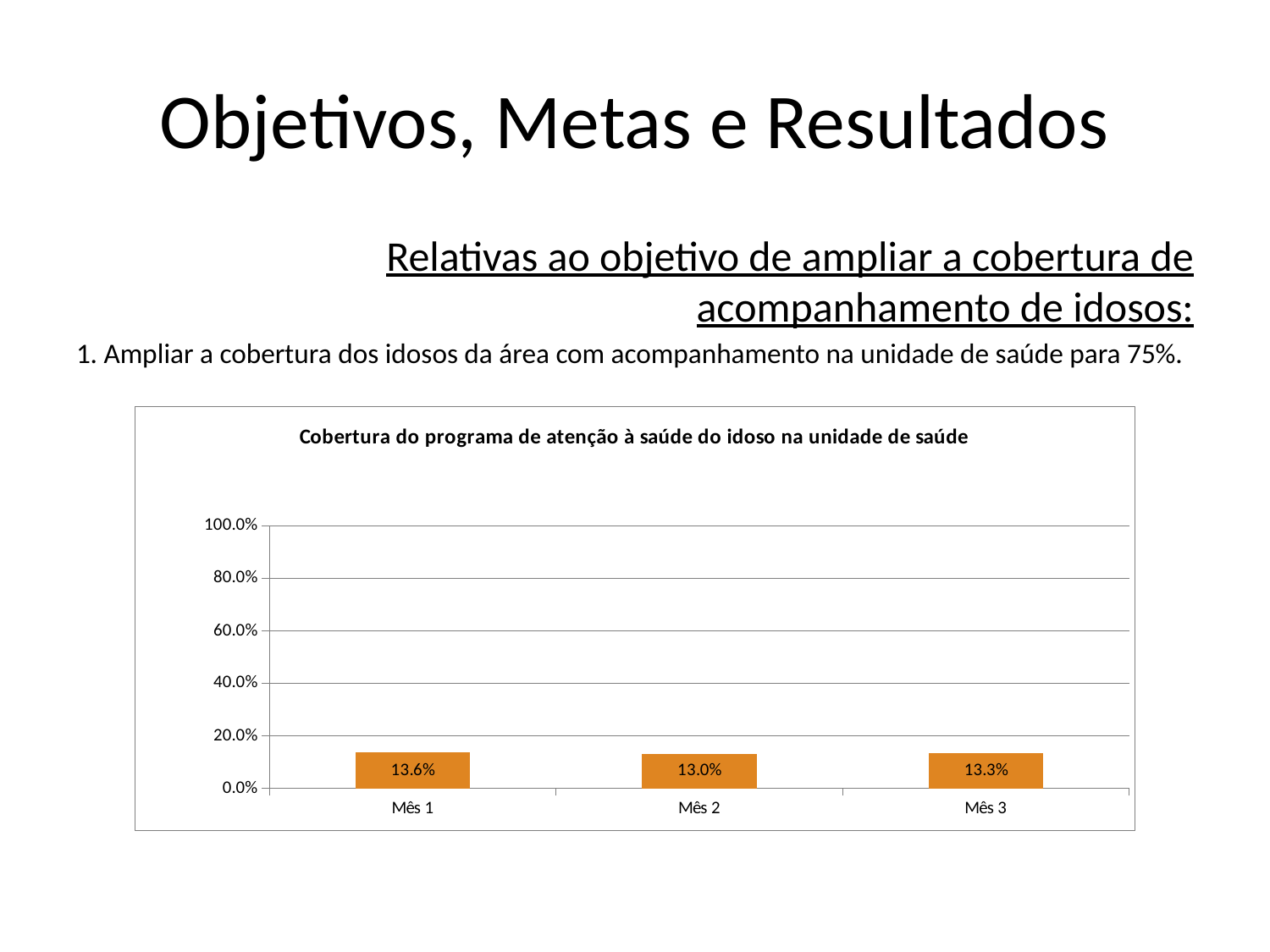
What is the title of the chart? Cobertura do programa de atenção à saúde do idoso na unidade de saúde What is the value for Mês 3? 13.3% Which month has the highest coverage value? Mês 1 What is the difference between the values for Mês 3 and Mês 2? 0.3% Which is larger, the value for Mês 1 or the value for Mês 3? Mês 1 What is the value for Mês 2? 13.0% What kind of chart is shown on the slide? bar chart What is the difference between the values for Mês 1 and Mês 2? 0.6% How many months (categories) are shown on the x axis? 3 Is the value for Mês 2 greater or less than 20.0%? less What is the value for Mês 1? 13.6% Which month has the lowest coverage value? Mês 2